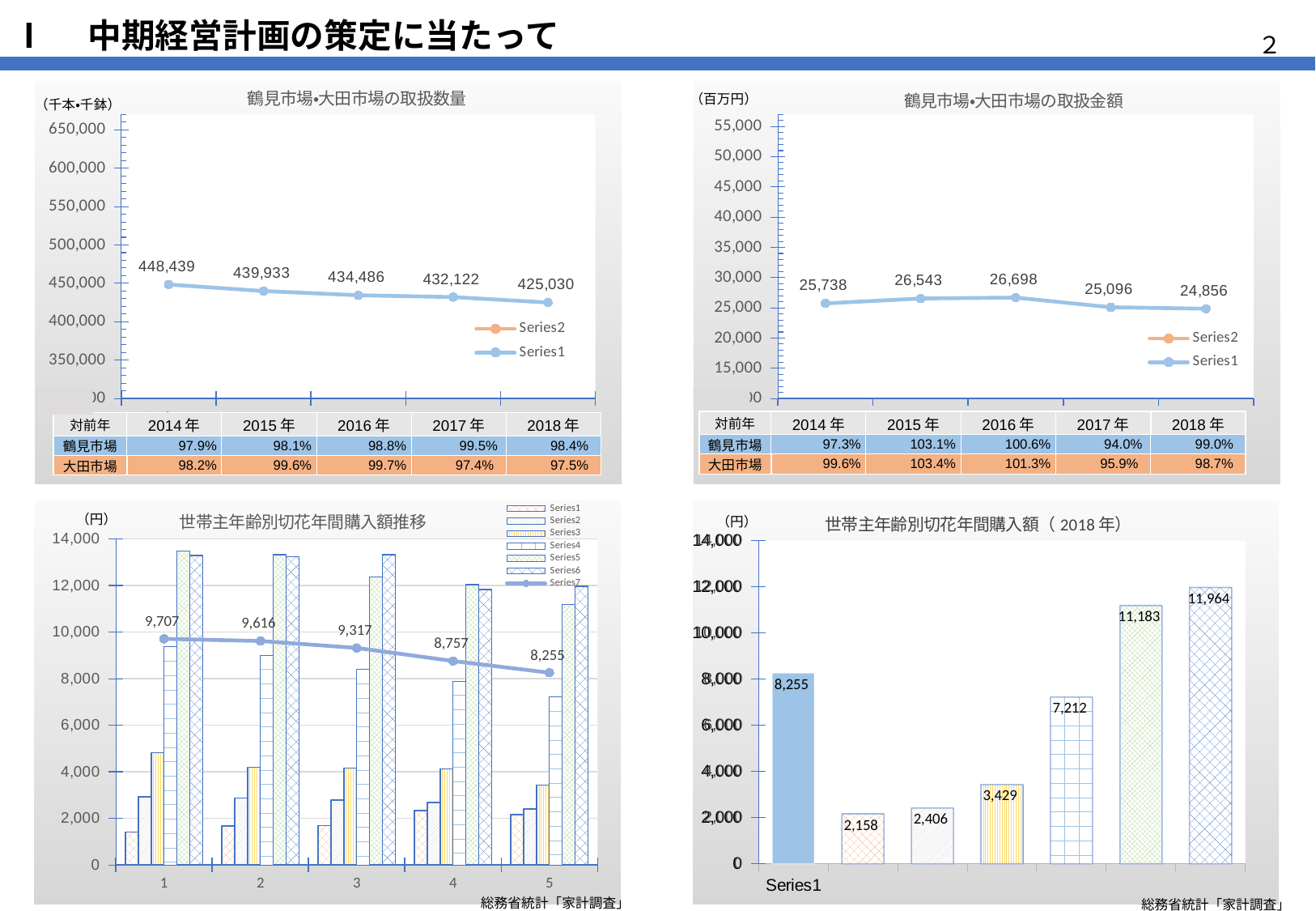
In the bottom-right chart titled 世帯主年齢別切花年間購入額（2018年）, what is the value of the tallest bar? 11,964 In the bottom-right chart titled 世帯主年齢別切花年間購入額（2018年）, how many bars are plotted? 7 In the top-left chart titled 鶴見市場・大田市場の取扱数量, what is the value for 2014年? 448,439 In the top-left chart titled 鶴見市場・大田市場の取扱数量, do the values rise or fall from 2014年 to 2018年? fall In the top-right chart titled 鶴見市場・大田市場の取扱金額, which year has the highest value? 2016年 In the bottom-left chart titled 世帯主年齢別切花年間購入額推移, how many series does the legend list? 7 In the top-left chart titled 鶴見市場・大田市場の取扱数量, what is the difference between the 2014年 and 2018年 values? 23,409 In the top-right chart titled 鶴見市場・大田市場の取扱金額, what is the value for 2017年? 25,096 In the top-left chart titled 鶴見市場・大田市場の取扱数量, what is the value for 2018年? 425,030 In the top-right chart titled 鶴見市場・大田市場の取扱金額, which year has the lowest value? 2018年 In the top-right chart titled 鶴見市場・大田市場の取扱金額, is the value for 2015年 greater or less than 30,000? less In the bottom-left chart titled 世帯主年齢別切花年間購入額推移, what is the line value at category 3? 9,317